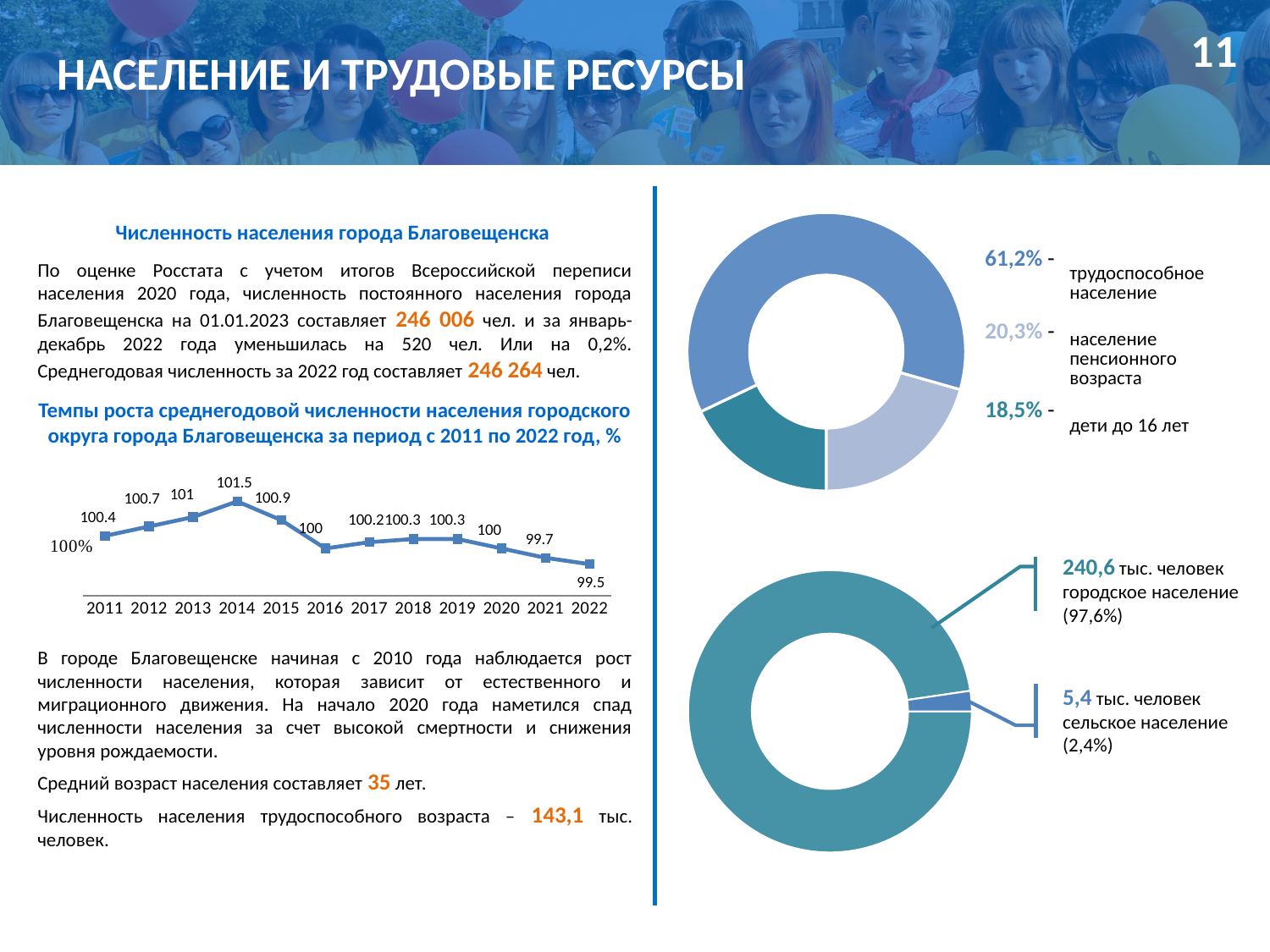
What kind of chart shows the average annual population growth rates from 2011 to 2022? line chart On the line chart of average annual population growth rates, what is the value for 2022? 99.5 On the line chart of average annual population growth rates, which year has the lowest value? 2022 On the line chart of average annual population growth rates, how many years are plotted? 12 On the top-right donut chart, what share is children under 16 (дети до 16 лет)? 18,5% On the line chart of average annual population growth rates, what is the value for 2014? 101.5 On the line chart of average annual population growth rates, which year has the highest value? 2014 On the line chart of average annual population growth rates, which is larger: the value for 2012 or the value for 2021? 2012 On the line chart of average annual population growth rates, what is the difference between the values for 2014 and 2022? 2 On the top-right donut chart, what share is the working-age population (трудоспособное население)? 61,2% On the bottom-right donut chart, what is the value for the rural population (сельское население)? 5,4 тыс. человек On the line chart of average annual population growth rates, do the values rise or fall from 2019 to 2022? fall